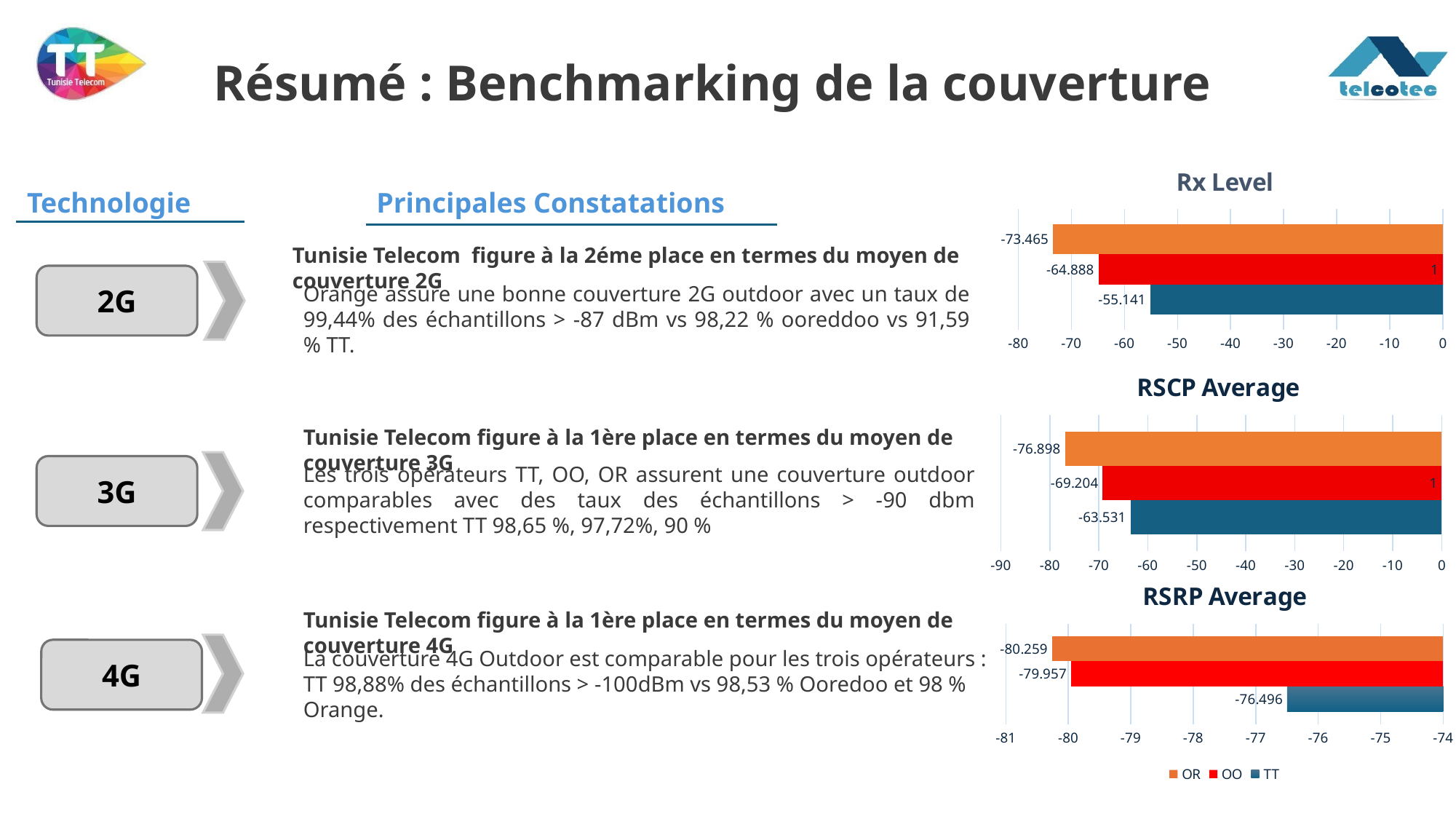
What kind of chart is the RSRP Average chart? Bar chart In the RSCP Average chart, what is the value for OO? -69.204 In the Rx Level chart, what is the value for OR? -73.465 In the RSRP Average chart, what is the value for TT? -76.496 In the Rx Level chart, what is the difference between the OO value and the OR value? 8.577 In the Rx Level chart, what is the value for TT? -55.141 In the Rx Level chart, which operator has the highest value? TT In the RSCP Average chart, which operator has the lowest value? OR In the RSCP Average chart, what is the difference between the TT value and the OO value? 5.673 In the Rx Level chart, is the value for TT greater or less than -60? greater How many series does the legend at the bottom of the slide list? 3 In the RSCP Average chart, is the value for OO larger than the value for OR? Yes